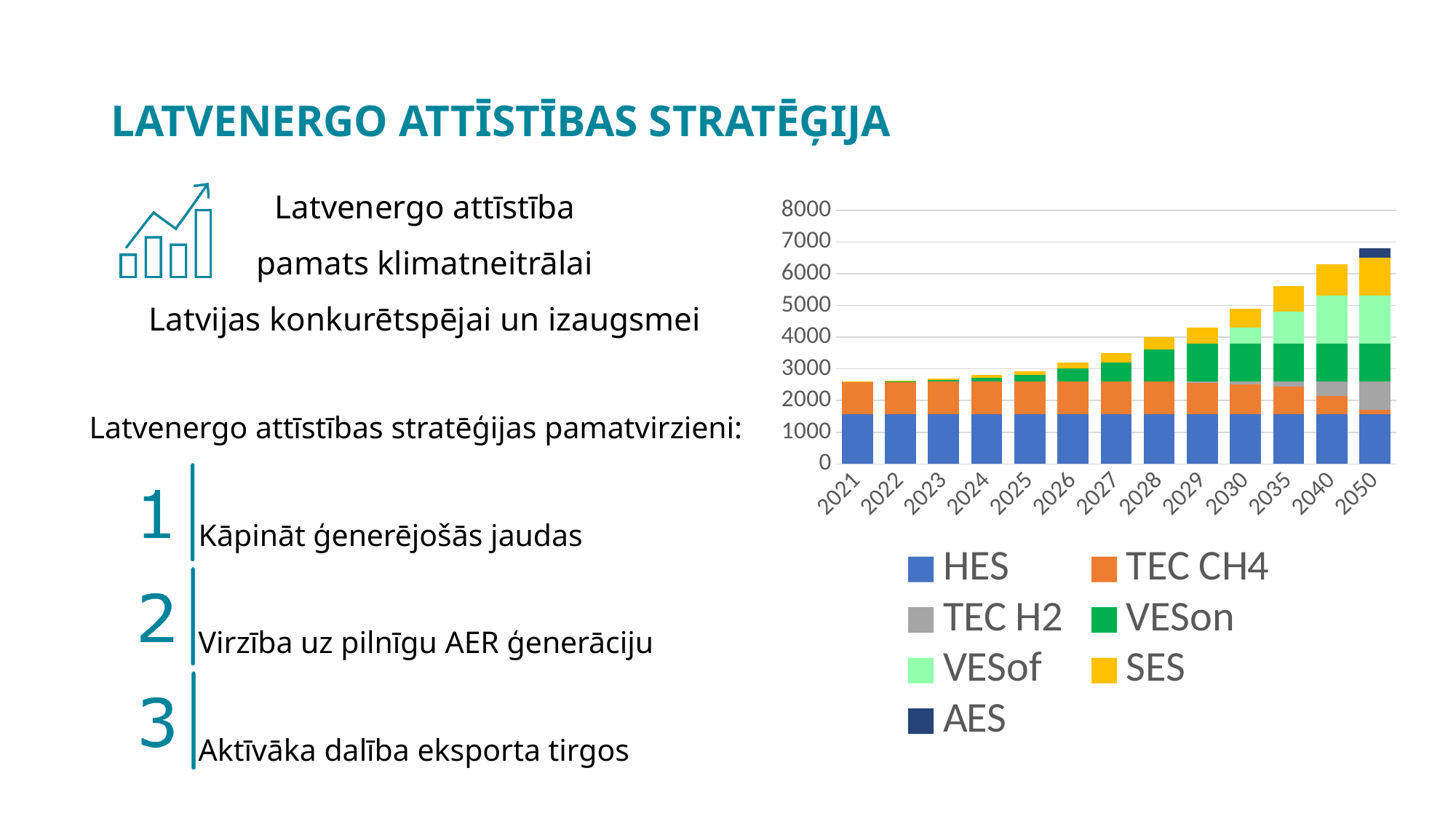
Which series forms the bottom segment of each stacked bar? HES Is the HES value for 2021 greater or less than 2000? less Which year has the highest total bar in the chart? 2050 What kind of chart is shown on the slide? stacked bar chart Which total is larger, 2040 or 2025? 2040 Is the total for 2050 greater or less than 6000? greater How many years are shown on the x axis of the chart? 13 Which series is shown in dark navy blue in the legend? AES Is the total for 2021 greater or less than 3000? less How many series does the chart legend list? 7 Do the total bar heights rise or fall from 2021 to 2050? rise